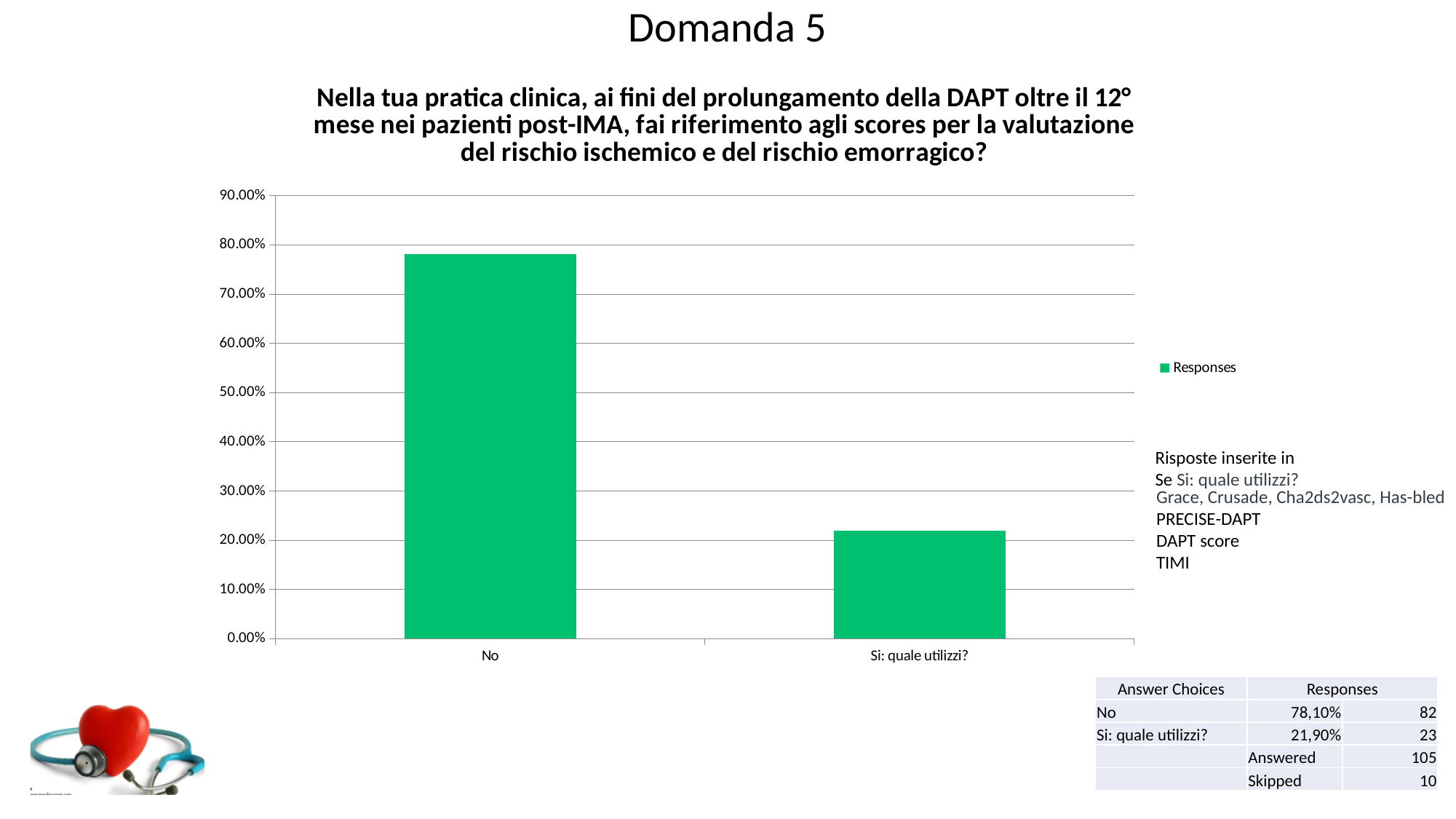
What kind of chart is shown on the slide? bar chart What is the name of the series shown in the chart legend? Responses How many series does the chart legend list? 1 Which category has the highest bar in the chart? No Is the value for "No" greater or less than 80.00%? less Is the value for "No" greater or less than 70.00%? greater Is the value for "Si: quale utilizzi?" greater or less than 30.00%? less According to the table on the slide, what percentage of responses is shown for "Si: quale utilizzi?"? 21,90% Which bar is taller, "No" or "Si: quale utilizzi?"? No According to the table on the slide, what percentage of responses is shown for "No"? 78,10% Which category has the lowest bar in the chart? Si: quale utilizzi? How many categories are plotted on the x axis of the chart? 2